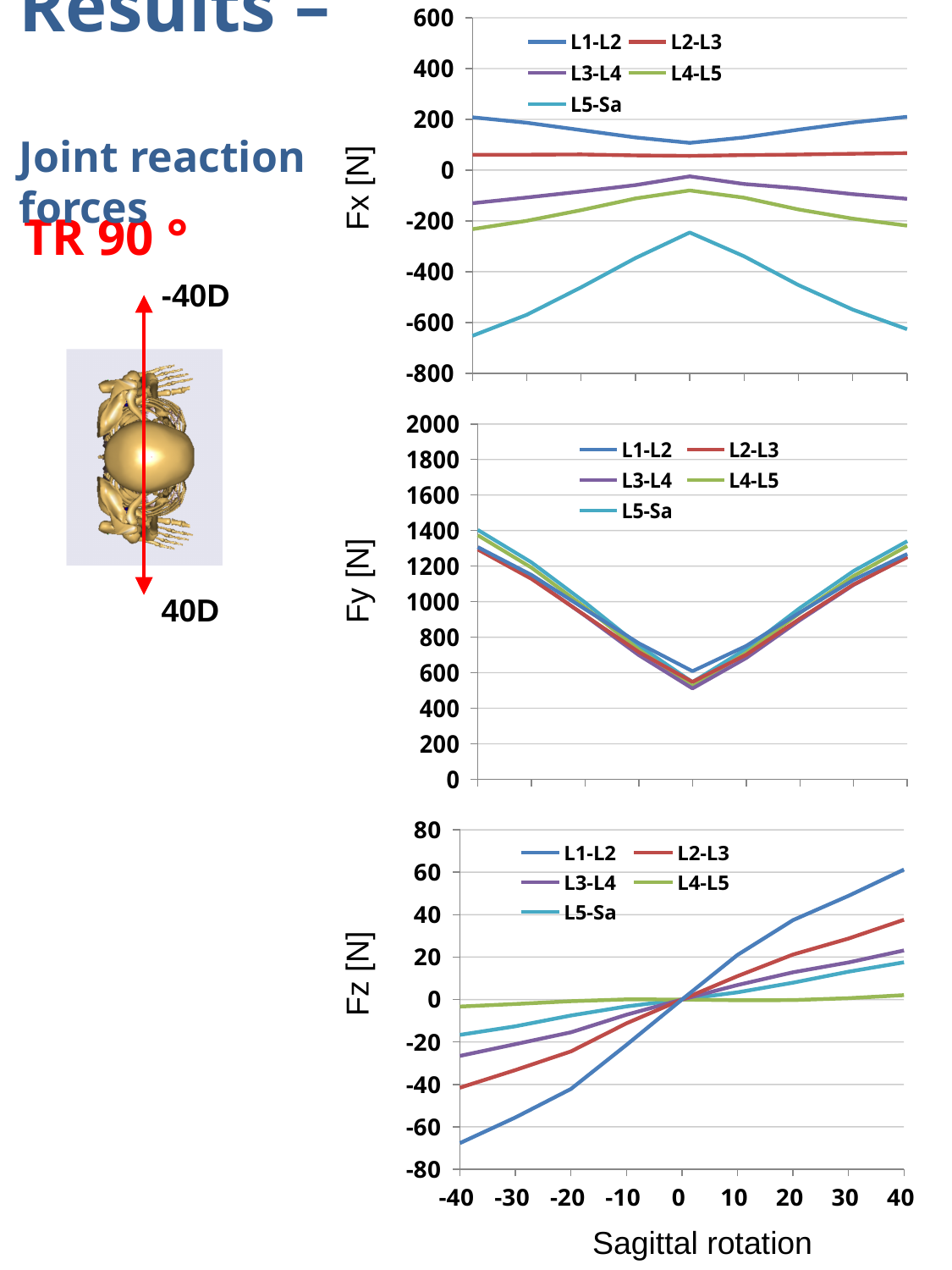
What kind of chart is the Fx [N] chart? line chart How many series does the legend of the Fy [N] chart list? 5 In the Fz [N] chart, is the value for L1-L2 at a sagittal rotation of 40 greater or less than 40? greater In the Fy [N] chart, is the value for L5-Sa at a sagittal rotation of -40 greater or less than 1200? greater In the Fx [N] chart, which series has the lowest values across the whole range of sagittal rotation? L5-Sa In the Fz [N] chart, which is larger at a sagittal rotation of 40: L2-L3 or L4-L5? L2-L3 In the Fz [N] chart, how many tick values are shown on the Sagittal rotation axis? 9 In the Fy [N] chart, do the values fall or rise as sagittal rotation goes from -40 to 0? fall In the Fz [N] chart, do the values rise or fall as sagittal rotation increases from -40 to 40? rise In the Fx [N] chart, is the value for L5-Sa at a sagittal rotation of -40 greater or less than -600? less In the Fz [N] chart, which series has the highest value at a sagittal rotation of 40? L1-L2 In the Fx [N] chart, which series has the highest values across the whole range of sagittal rotation? L1-L2